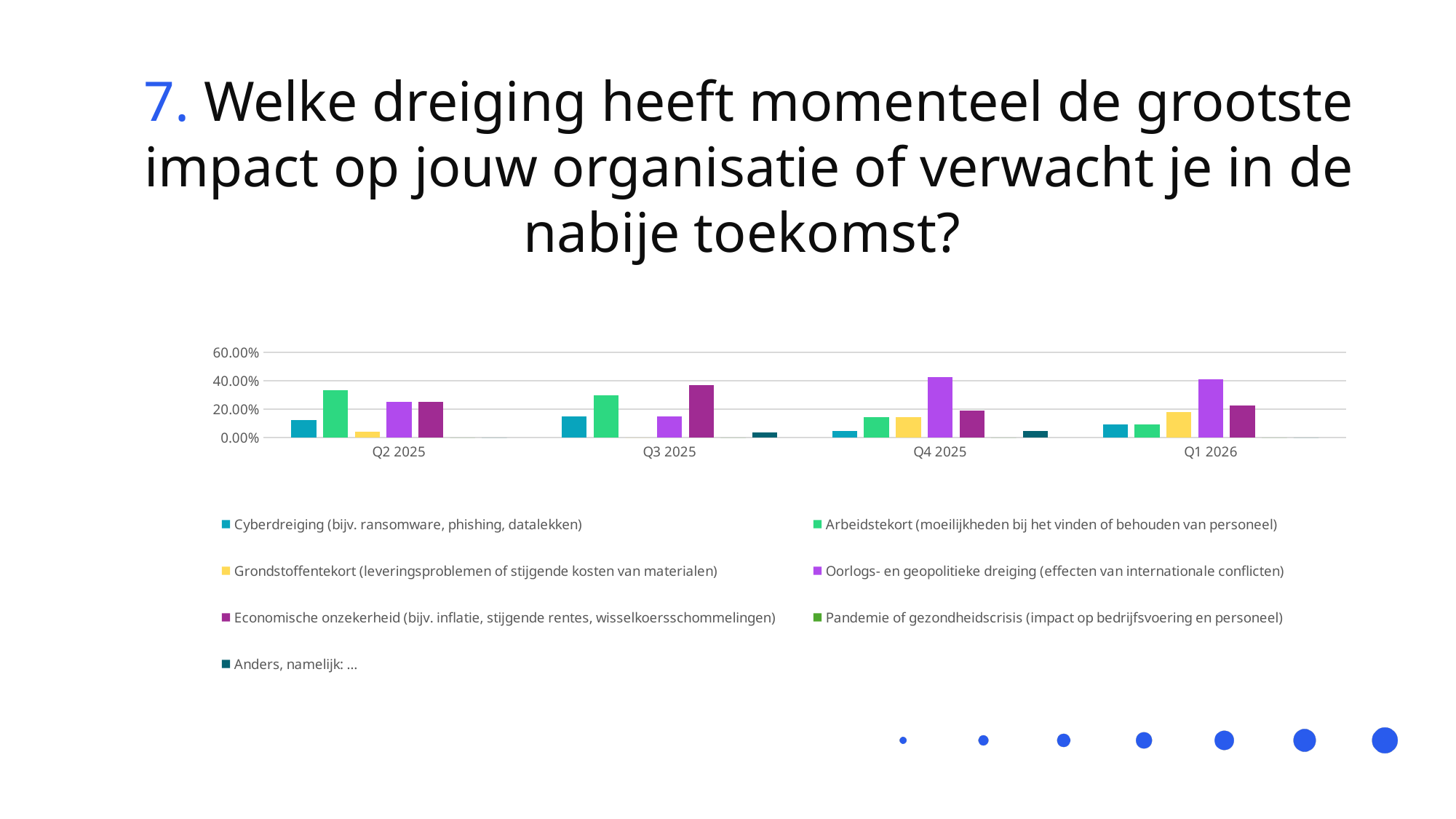
Is the value for Economische onzekerheid in Q3 2025 greater or less than 40.00%? less How many series does the chart legend list? 7 Which threat has the highest bar in Q3 2025? Economische onzekerheid In Q1 2026, which is larger: Grondstoffentekort or Cyberdreiging? Grondstoffentekort What is the highest value shown on the y axis of the chart? 60.00% Which threat has the highest bar in Q4 2025? Oorlogs- en geopolitieke dreiging Does the value for Arbeidstekort rise or fall from Q2 2025 to Q1 2026? Fall Which threat has the highest bar in Q2 2025? Arbeidstekort Is the value for Arbeidstekort in Q2 2025 greater or less than 20.00%? greater Is the value for Cyberdreiging in Q2 2025 greater or less than 20.00%? less How many quarters are shown along the x axis of the chart? 4 What kind of chart is shown on the slide? Bar chart